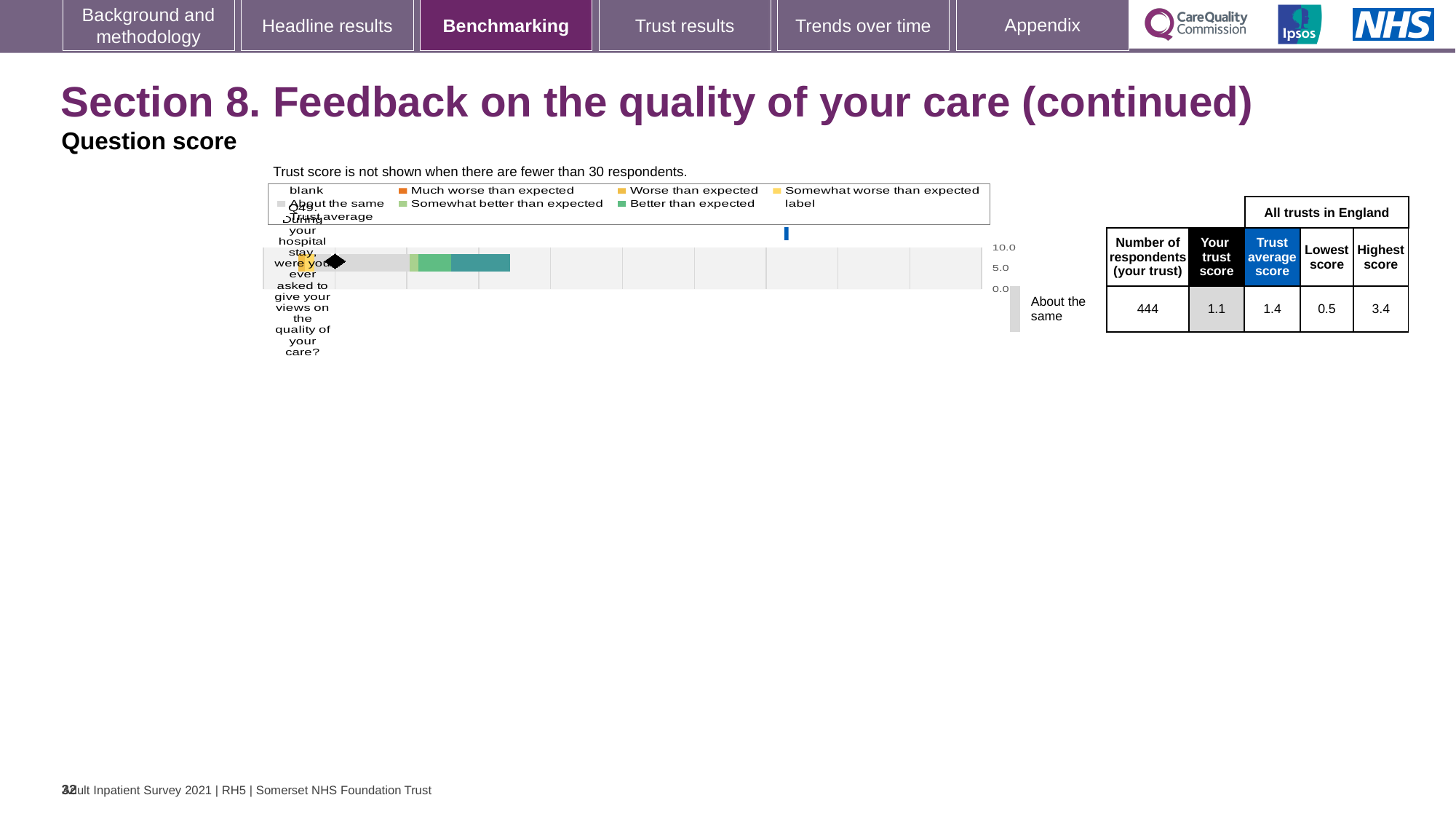
What colour does the legend use for 'Much worse than expected'? orange What kind of chart is shown on the slide? bar chart What is the trust score for Q49 shown on the slide? 1.1 What is the trust average score for Q49 shown on the slide? 1.4 What is the highest score across all trusts in England for Q49? 3.4 How many respondents answered Q49 at this trust? 444 Which is larger for Q49: the trust score or the trust average score? trust average score What is the lowest score across all trusts in England for Q49? 0.5 Which benchmark category is the trust's Q49 score placed in? About the same What is the difference between the highest score and the lowest score for Q49? 2.9 How many questions (categories) are plotted on the chart? 1 Which question number is plotted on the chart? Q49